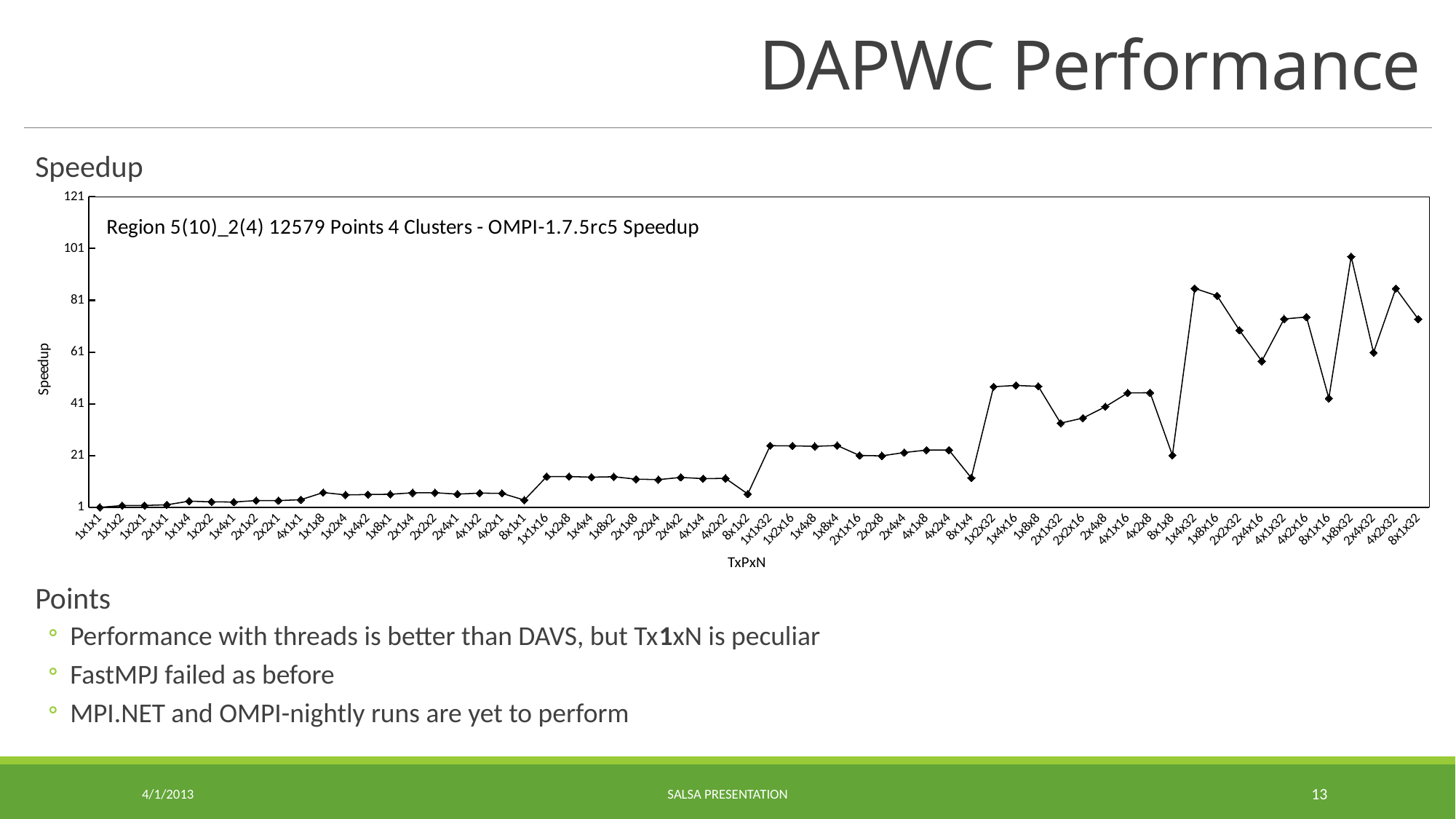
Which TxPxN configuration has the lowest speedup? 1x1x1 What kind of chart is shown on the slide? line chart Is the speedup for 1x4x32 greater or less than 81? greater Which has the larger speedup, 1x4x32 or 4x2x16? 1x4x32 Is the speedup for 2x2x32 greater or less than 61? greater Overall, does the speedup rise or fall moving from left to right along the x axis? rise What is the title printed inside the chart? Region 5(10)_2(4) 12579 Points 4 Clusters - OMPI-1.7.5rc5 Speedup Which has the larger speedup, 1x8x32 or 8x1x32? 1x8x32 Which TxPxN configuration has the highest speedup? 1x8x32 What is the label of the x axis? TxPxN Is the speedup for 2x1x32 greater or less than 41? less